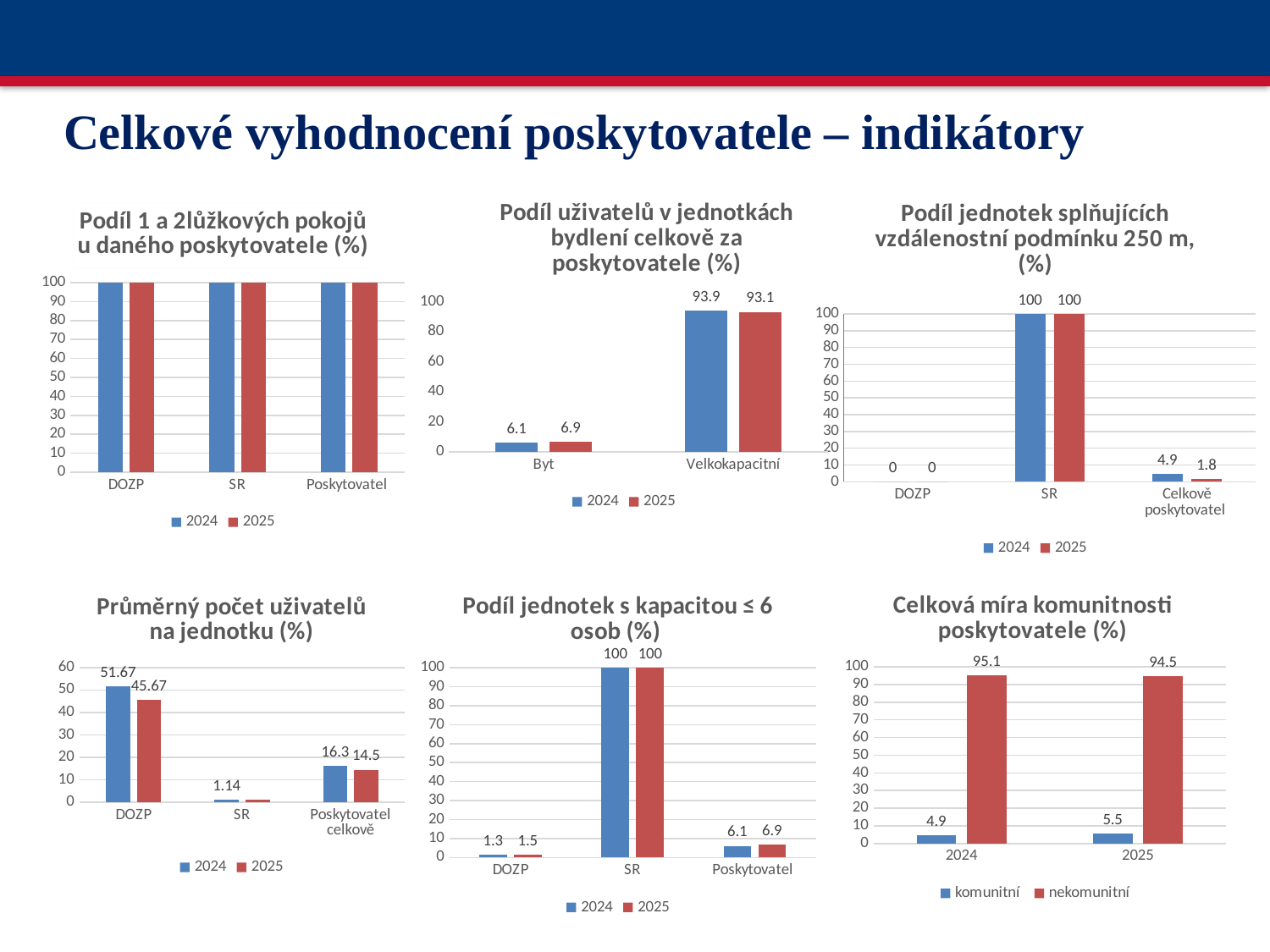
In the chart 'Podíl uživatelů v jednotkách bydlení celkově za poskytovatele (%)', what is the 2025 value for Byt? 6.9 In the chart 'Průměrný počet uživatelů na jednotku (%)', what is the difference between the 2024 and 2025 values for DOZP? 6 In the chart 'Podíl jednotek splňujících vzdálenostní podmínku 250 m, (%)', which category has the lowest values? DOZP In the chart 'Celková míra komunitnosti poskytovatele (%)', what series does the legend list? komunitní, nekomunitní In the chart 'Podíl uživatelů v jednotkách bydlení celkově za poskytovatele (%)', what is the 2024 value for Velkokapacitní? 93.9 In the chart 'Průměrný počet uživatelů na jednotku (%)', what is the 2024 value for DOZP? 51.67 How many categories are shown on the x axis of the chart 'Podíl 1 a 2lůžkových pokojů u daného poskytovatele (%)'? 3 In the chart 'Podíl jednotek s kapacitou ≤ 6 osob (%)', what is the 2025 value for Poskytovatel? 6.9 In the chart 'Podíl jednotek s kapacitou ≤ 6 osob (%)', which category has the highest values? SR In the chart 'Celková míra komunitnosti poskytovatele (%)', what is the nekomunitní value for 2025? 94.5 In the chart 'Podíl jednotek splňujících vzdálenostní podmínku 250 m, (%)', what is the 2024 value for Celkově poskytovatel? 4.9 In the chart 'Celková míra komunitnosti poskytovatele (%)', which is larger: the komunitní value for 2024 or for 2025? 2025